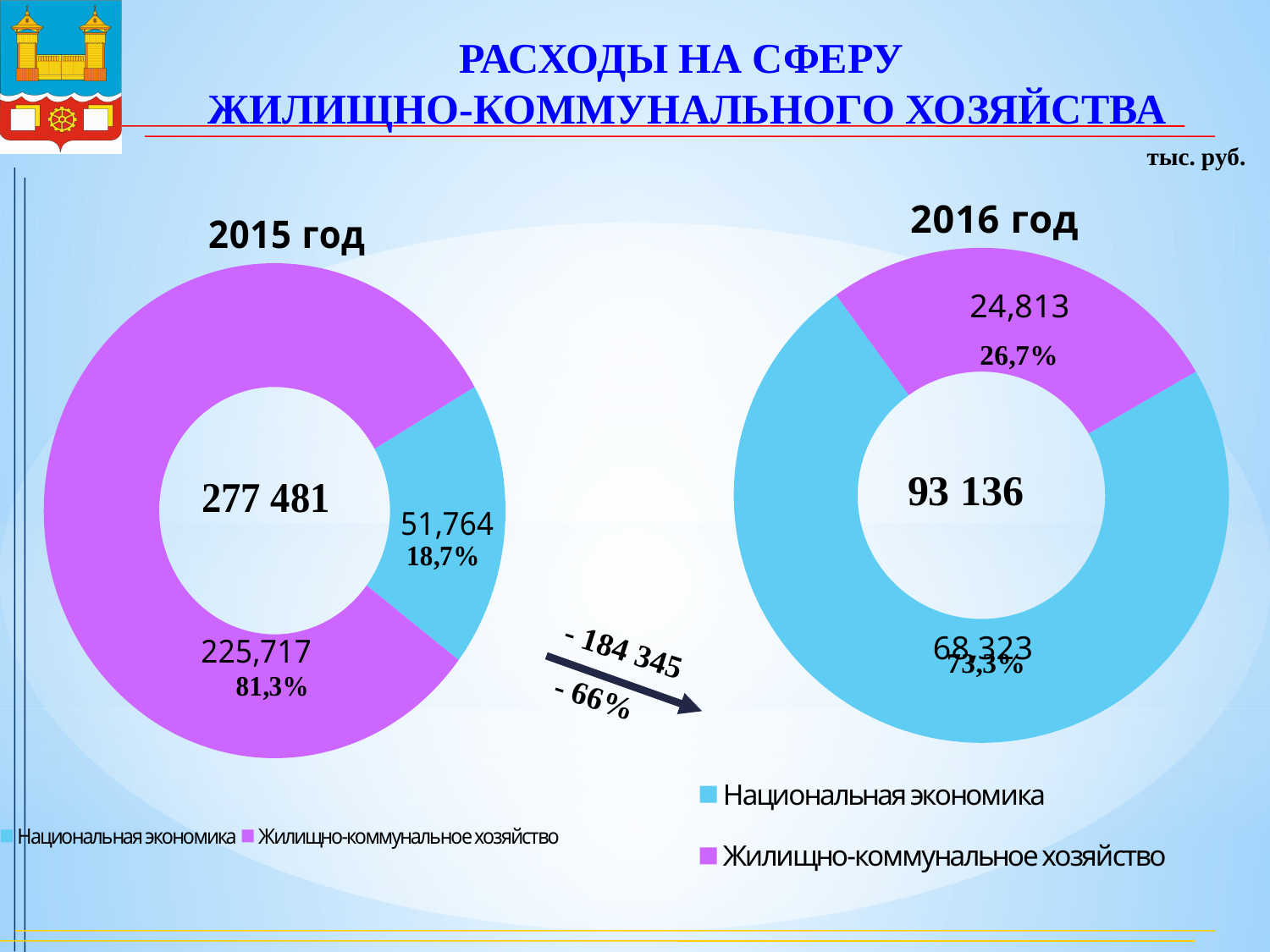
How many categories does the legend of the 2016 год chart list? 2 Which colour represents Национальная экономика in the charts? Light blue What total is shown in the centre of the 2016 год chart? 93 136 In the 2016 год chart, what is the value for Национальная экономика? 68,323 In the 2016 год chart, what is the value for Жилищно-коммунальное хозяйство? 24,813 In the 2016 год chart, which category is the smallest? Жилищно-коммунальное хозяйство In the 2015 год chart, what share of the total does Жилищно-коммунальное хозяйство have? 81,3% In the 2016 год chart, what share of the total does Национальная экономика have? 73,3% In the 2015 год chart, what is the value for Национальная экономика? 51,764 In the 2015 год chart, which category is the largest? Жилищно-коммунальное хозяйство What kind of chart is used for 2015 год? Donut (pie) chart In the 2015 год chart, what is the value for Жилищно-коммунальное хозяйство? 225,717